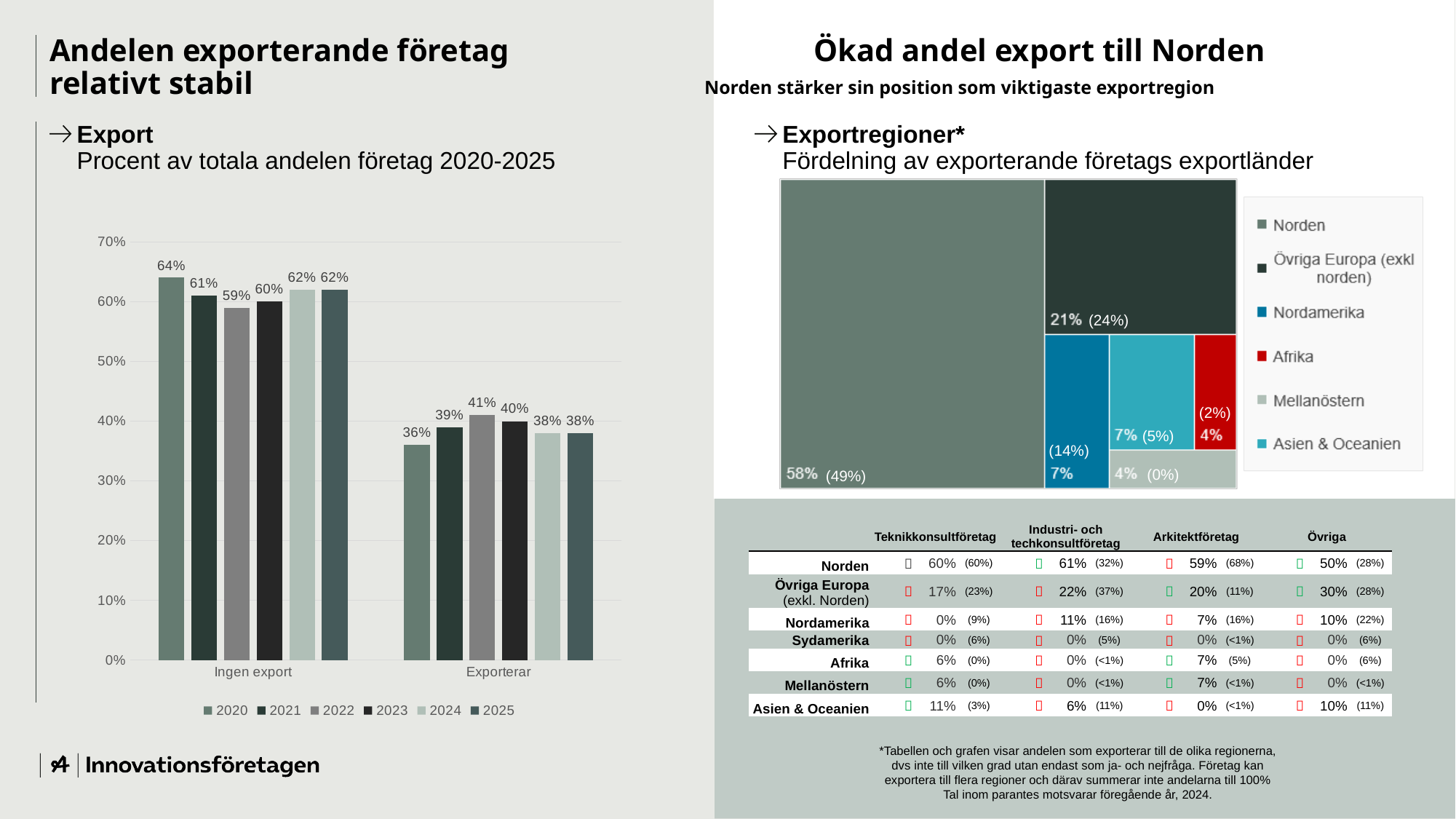
What kind of chart is the left chart (Export)? Bar chart In the left chart (Export), what is the value for 2022 in the Exporterar category? 41% In the left chart (Export), which year has the lowest value in the Ingen export category? 2022 In the right chart (Exportregioner), what is the current share for Norden? 58% In the left chart (Export), what is the difference between the 2020 and 2025 values in the Exporterar category? 2% In the right chart (Exportregioner), which region has the largest share? Norden In the left chart (Export), how many series does the legend list? 6 In the right chart (Exportregioner), how many regions does the legend list? 6 In the left chart (Export), what is the value for 2020 in the Ingen export category? 64% In the left chart (Export), which is larger: the 2021 value for Ingen export or the 2021 value for Exporterar? Ingen export In the right chart (Exportregioner), what is the value shown in parentheses for Övriga Europa (exkl norden)? (24%) In the left chart (Export), which year has the highest value in the Exporterar category? 2022